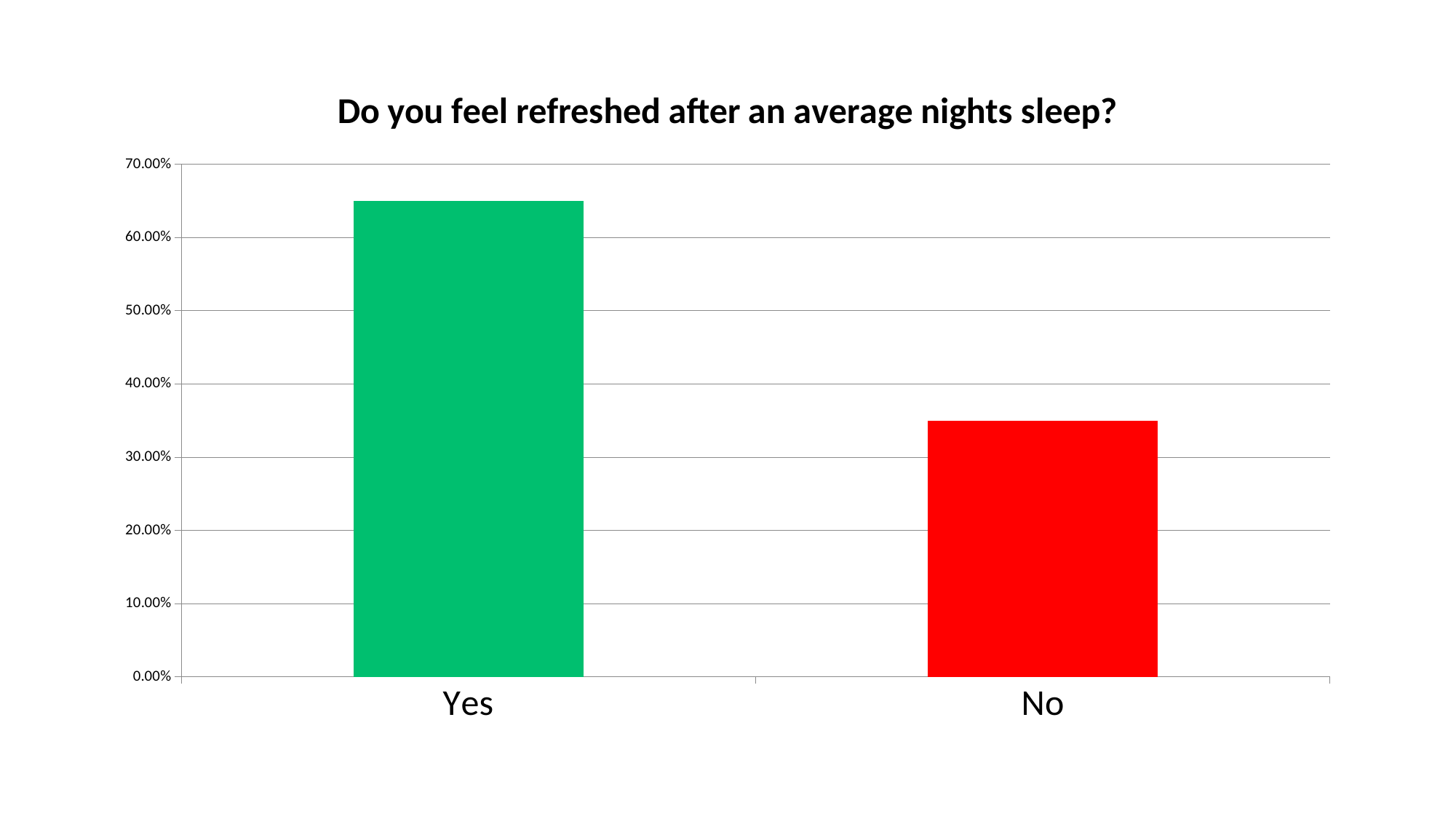
Is the value for No greater or less than 40.00%? less Which category has the highest value? Yes What kind of chart is shown on the slide? bar chart What is the title of the chart? Do you feel refreshed after an average nights sleep? Which is larger, the value for Yes or the value for No? Yes How many categories are shown on the x axis? 2 Do the values rise or fall from Yes to No along the x axis? fall Is the value for No greater or less than 30.00%? greater Which category has the lowest value? No What colour is the bar for No? red Is the value for Yes greater or less than 70.00%? less